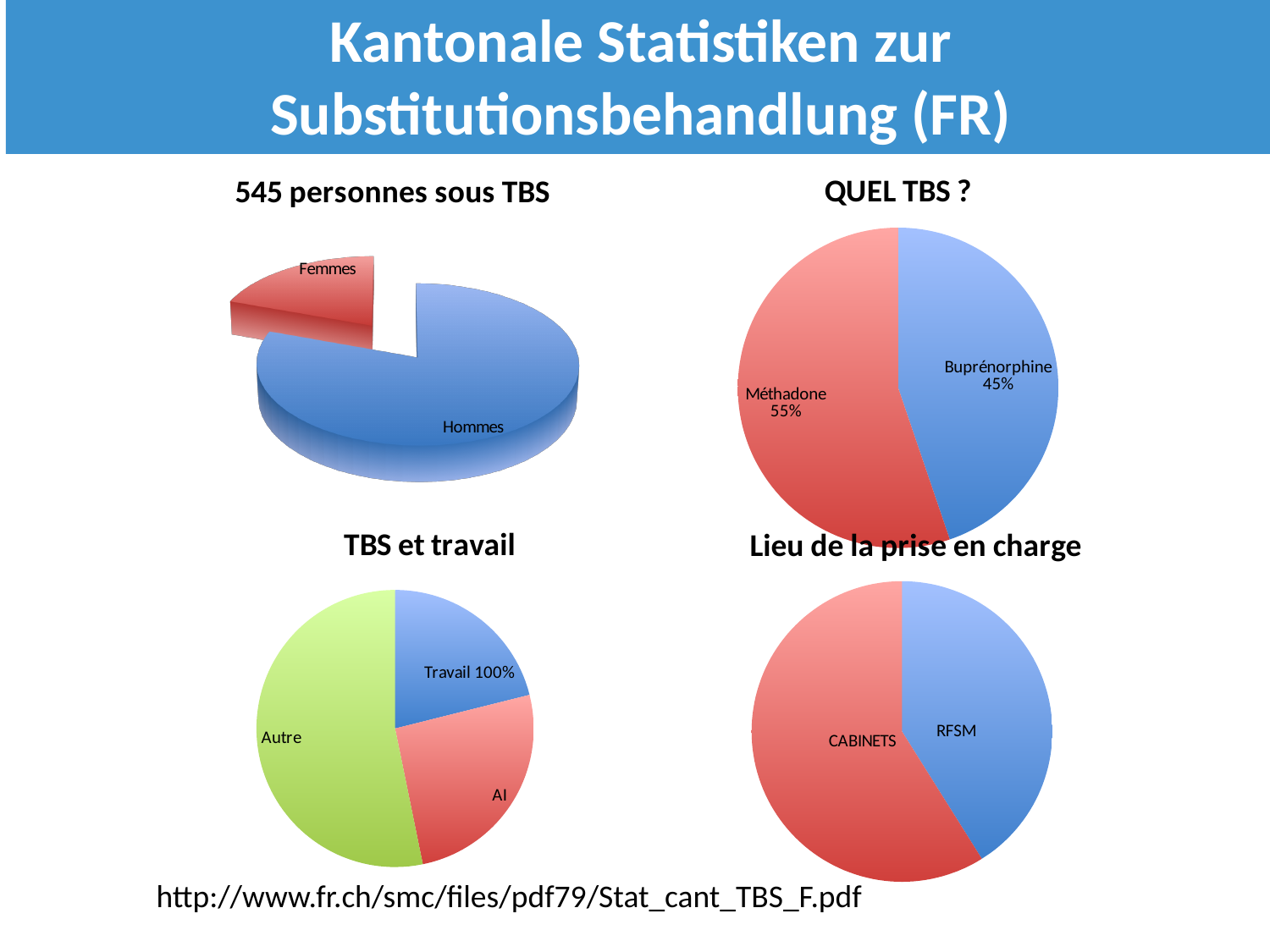
How many charts are shown on the slide? 4 In the 'QUEL TBS ?' chart, what is the difference in percentage points between Méthadone and Buprénorphine? 10 percentage points In the 'QUEL TBS ?' chart, what share of the pie is Méthadone? 55% What is the title of the top-left chart on the slide? 545 personnes sous TBS In the 'Lieu de la prise en charge' chart, which slice is larger, CABINETS or RFSM? CABINETS In the 'TBS et travail' chart, which category has the largest slice? Autre In the 'QUEL TBS ?' chart, what percentage is shown for Buprénorphine? 45% In the '545 personnes sous TBS' chart, which slice is larger, Hommes or Femmes? Hommes How many categories does the '545 personnes sous TBS' chart show? 2 In the 'QUEL TBS ?' chart, which slice is larger, Méthadone or Buprénorphine? Méthadone How many categories does the 'TBS et travail' chart show? 3 What kind of chart is the '545 personnes sous TBS' chart? Pie chart